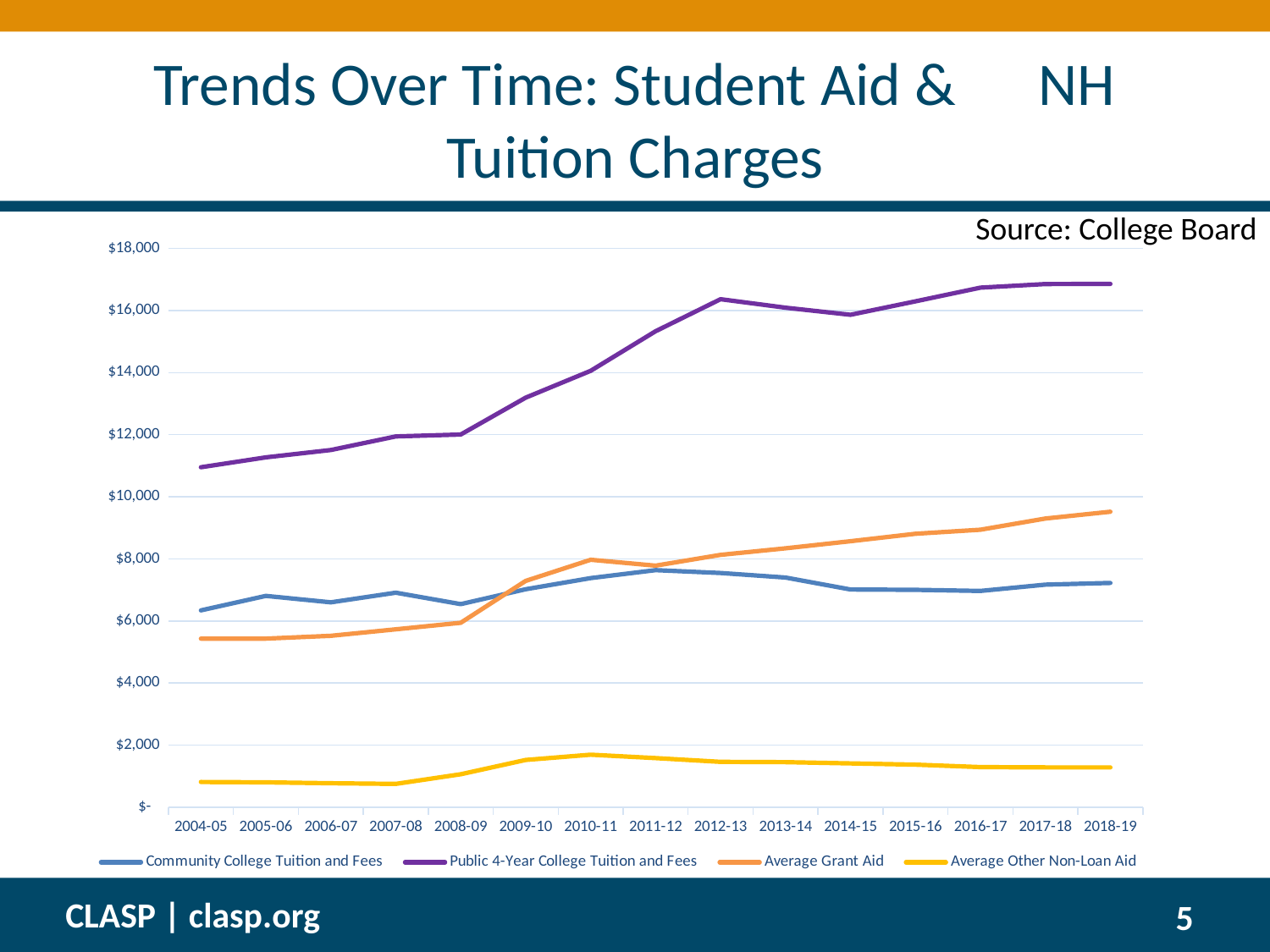
Is the value for Average Other Non-Loan Aid in 2010-11 greater or less than $2,000? less Is the value for Average Grant Aid in 2004-05 greater or less than $6,000? less Which series has the highest value in 2018-19? Public 4-Year College Tuition and Fees Which series has the lowest value in 2018-19? Average Other Non-Loan Aid How many academic years are plotted along the x axis? 15 In 2018-19, which is larger: Average Grant Aid or Community College Tuition and Fees? Average Grant Aid Is the value for Public 4-Year College Tuition and Fees in 2018-19 greater or less than $16,000? greater Does Public 4-Year College Tuition and Fees generally rise or fall from 2004-05 to 2018-19? Rise How many series does the legend list? 4 What kind of chart is shown on the slide? Line chart